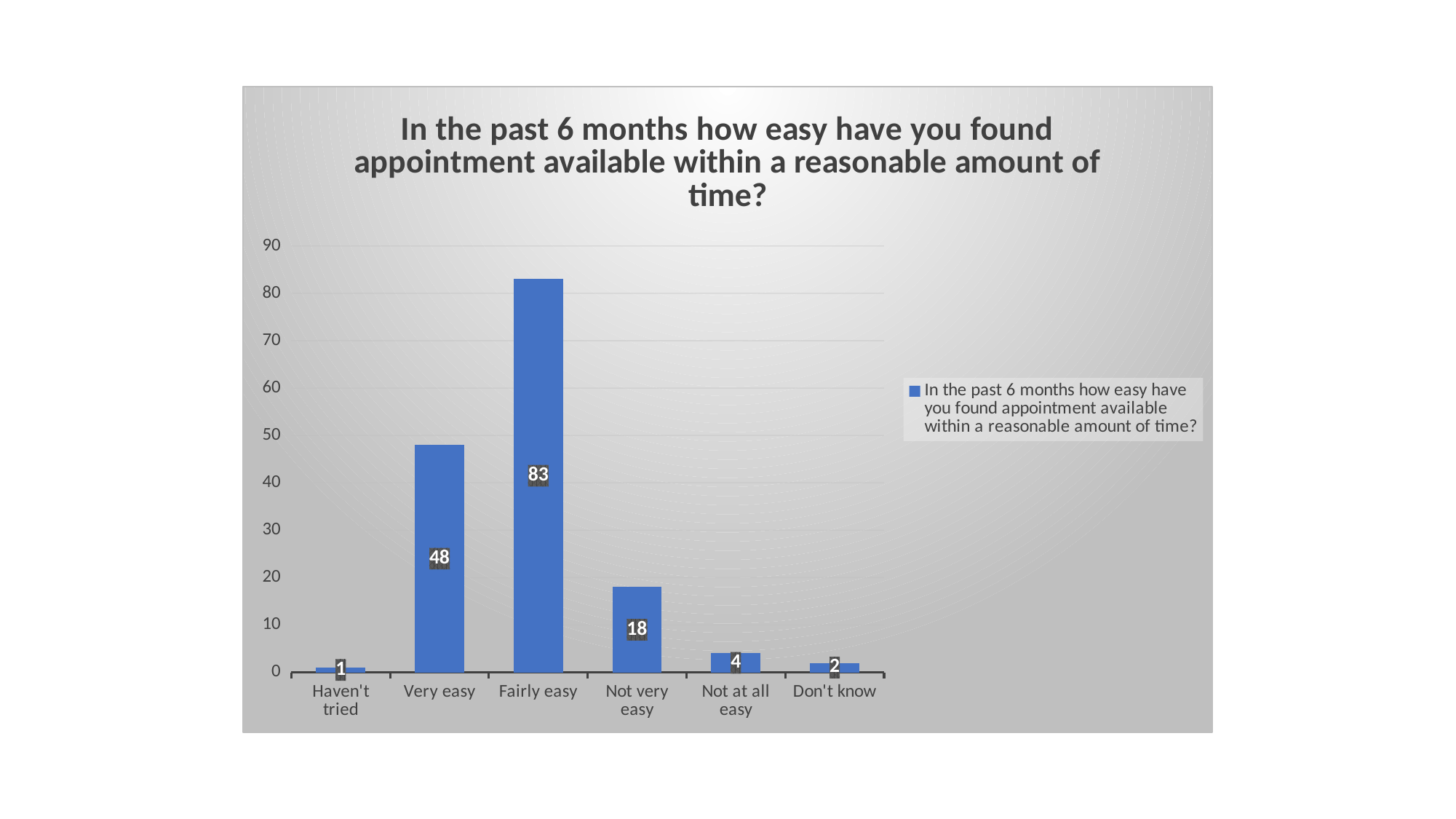
What is the value for Not at all easy? 4 Which is larger, the value for Not very easy or the value for Don't know? Not very easy Is the value for Very easy greater or less than 40? greater What kind of chart is shown on the slide? bar chart What is the value for Not very easy? 18 Which category has the highest value? Fairly easy Which category has the lowest value? Haven't tried What is the difference between the values for Fairly easy and Very easy? 35 What is the value for Fairly easy? 83 What is the value for Very easy? 48 What colour are the bars in the chart? blue How many categories are shown on the x axis? 6